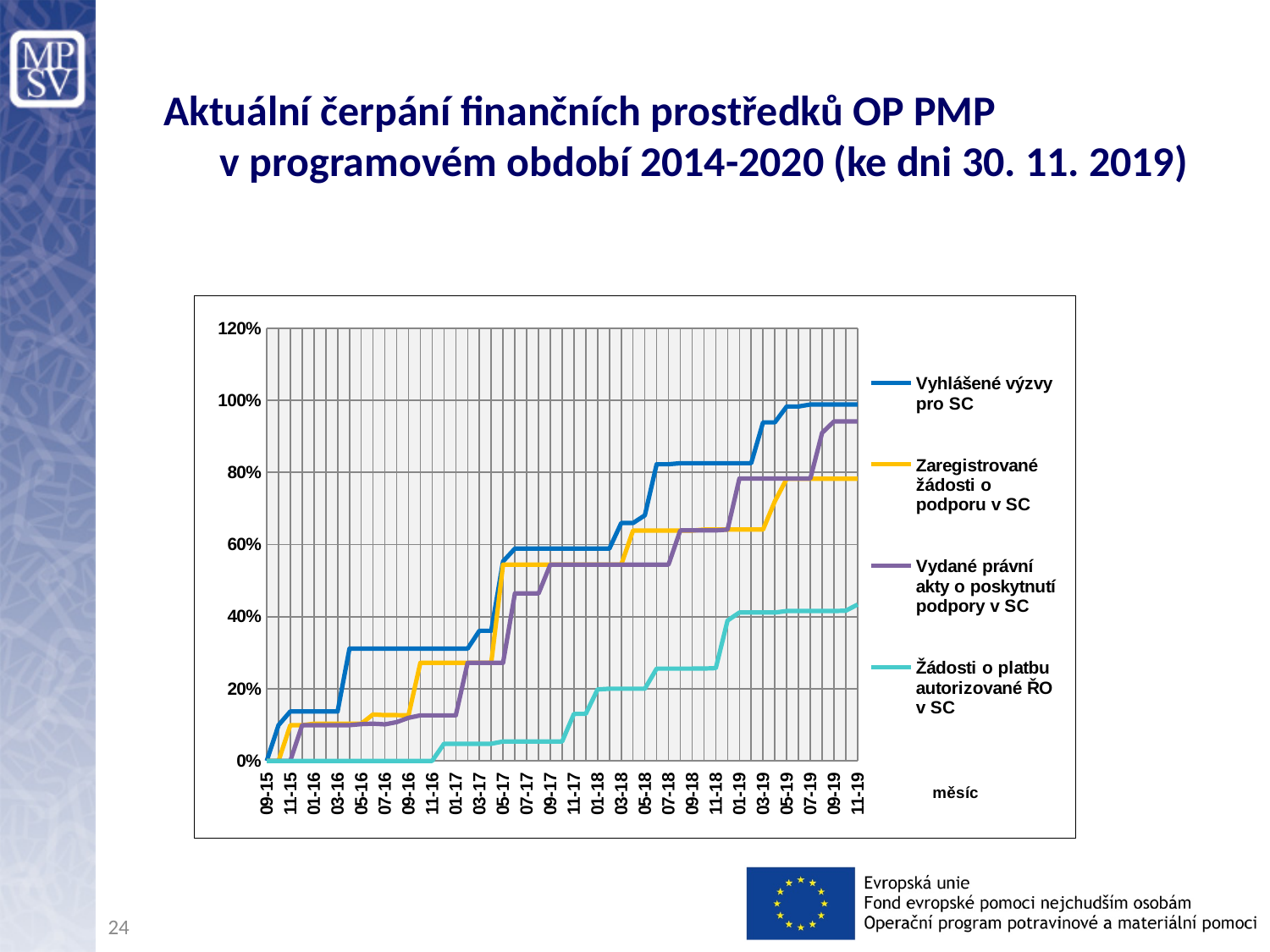
Which series has the lowest value at 11-19? Žádosti o platbu autorizované ŘO v SC What is the label of the x axis? měsíc Is the value for Zaregistrované žádosti o podporu v SC at 11-19 greater or less than 60%? greater Do the values for Vydané právní akty o poskytnutí podpory v SC rise or fall from 09-15 to 11-19? rise Which series has the highest value at 11-19? Vyhlášené výzvy pro SC What is the highest value shown on the y axis? 120% Is the value for Žádosti o platbu autorizované ŘO v SC at 11-19 greater or less than 60%? less At 01-18, which is larger: Vyhlášené výzvy pro SC or Žádosti o platbu autorizované ŘO v SC? Vyhlášené výzvy pro SC How many series does the legend list? 4 Is the value for Vyhlášené výzvy pro SC at 11-19 greater or less than 80%? greater How many month labels are shown on the x axis? 26 What kind of chart is shown on the slide? line chart